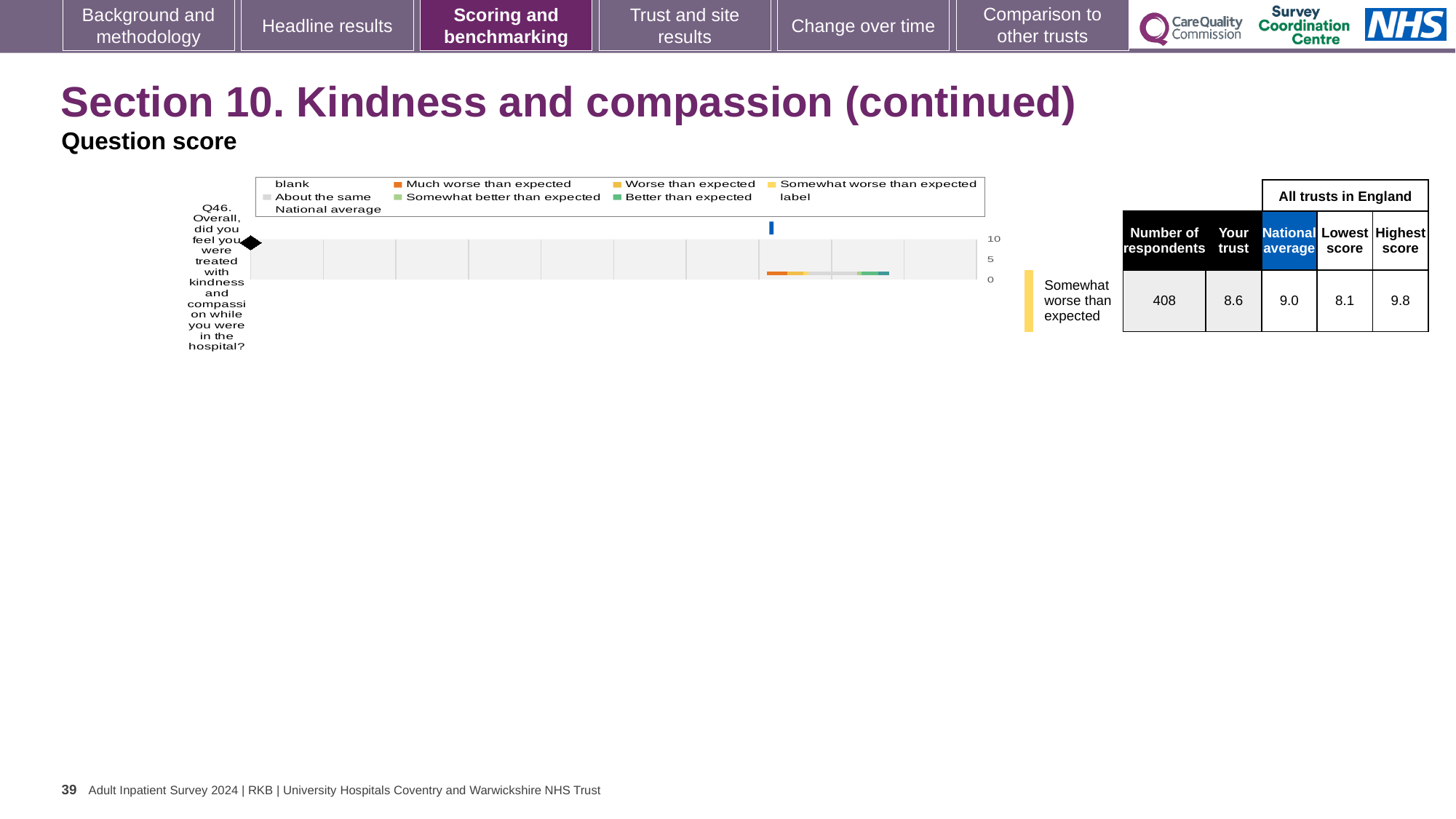
Which benchmark category is the trust's Q46 score assigned to? Somewhat worse than expected How many entries does the chart legend list? 9 What is the highest tick value shown on the chart's score axis? 10 Which is larger for Q46: the 'Your trust' score or the national average? National average What is the national average score for Q46 shown in the table? 9.0 What is the 'Your trust' score for Q46 in the table next to the chart? 8.6 What kind of chart is shown on the slide? bar chart What is the highest score among all trusts in England for Q46? 9.8 How many survey questions are plotted in the chart? 1 What is the lowest score among all trusts in England for Q46? 8.1 How many respondents answered Q46? 408 What is the difference between the highest score and the lowest score for Q46? 1.7